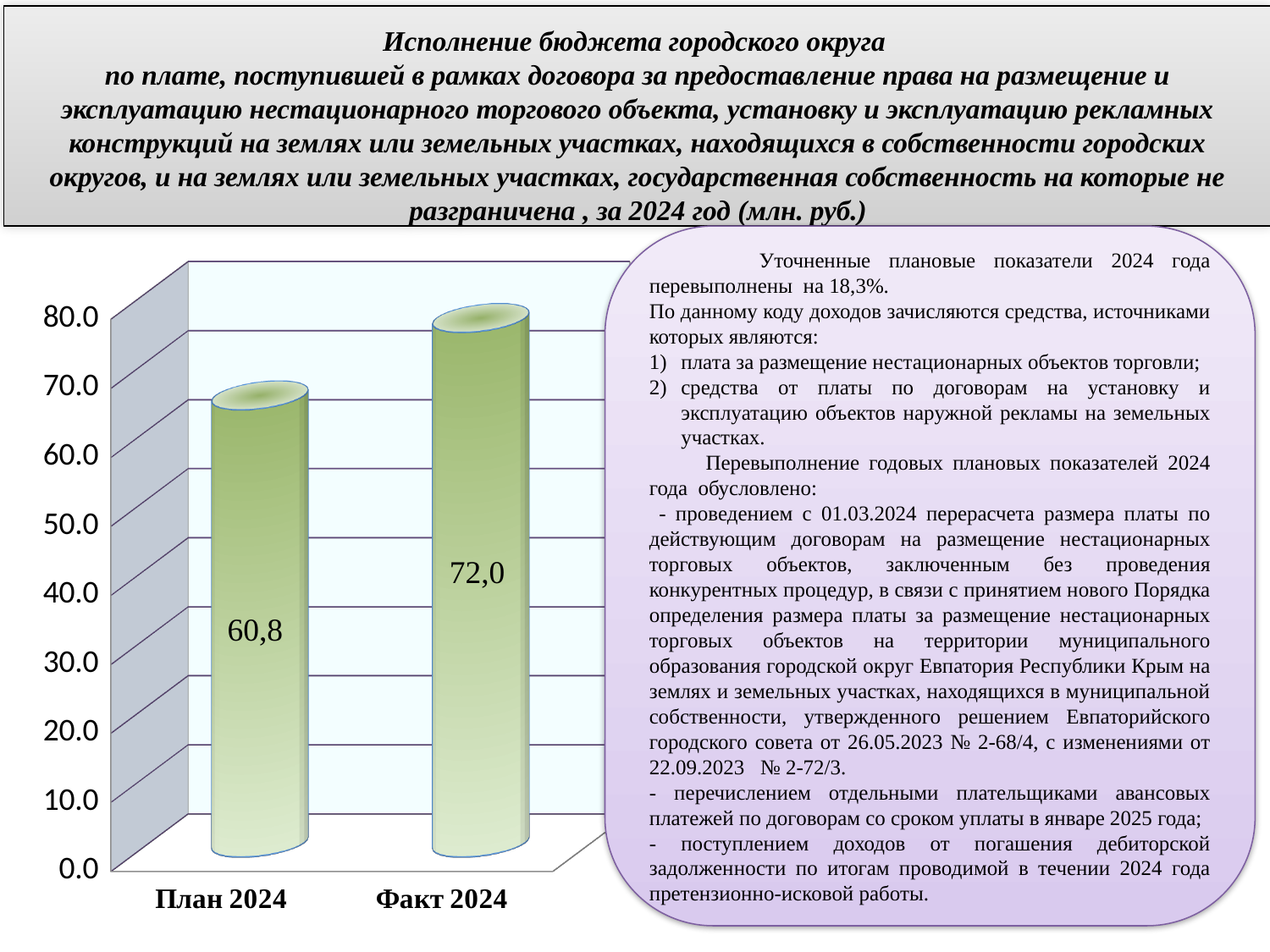
Is the value for Факт 2024 greater or less than 70.0? greater How many categories are shown on the chart? 2 Which category has the lowest value? План 2024 Which category has the highest value? Факт 2024 What kind of chart is shown on the slide? bar chart What is the value for План 2024? 60,8 What is the highest value shown on the vertical axis of the chart? 80.0 Do the values rise or fall from План 2024 to Факт 2024? rise What is the difference between the values for Факт 2024 and План 2024? 11,2 Which is larger, the value for План 2024 or the value for Факт 2024? Факт 2024 Is the value for План 2024 greater or less than 70.0? less What is the value for Факт 2024? 72,0